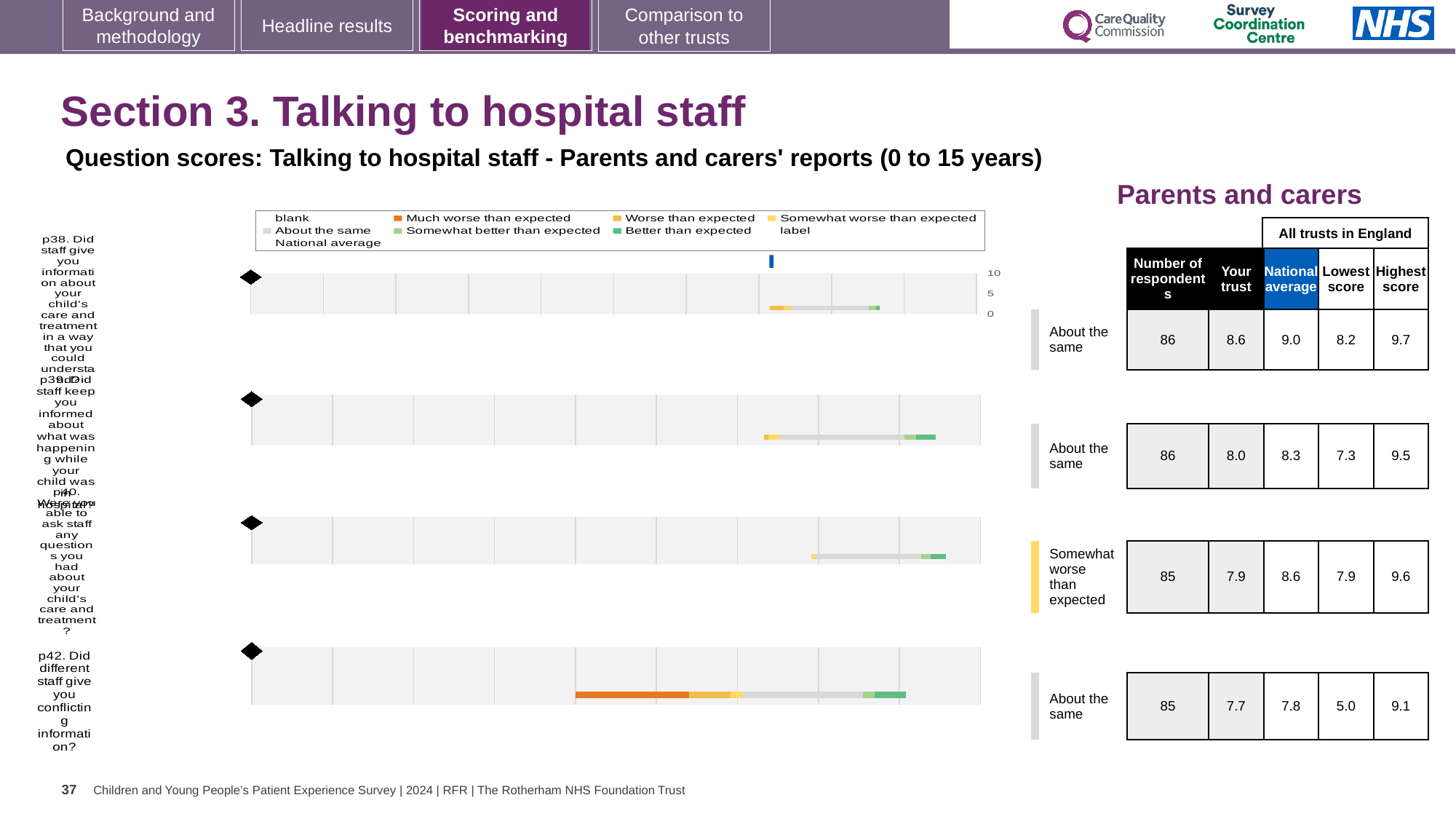
In the legend, which colour represents 'About the same'? grey What kind of chart is used for question p38 on the slide? bar chart Which question's chart is labelled 'Somewhat worse than expected' in the benchmark column? p40 In the table beside the charts, is the 'Your trust' score for p40 larger or smaller than the National average for p40? smaller How many entries does the legend above the charts list? 9 How many separate benchmark bar charts are shown on the slide? 4 In the table beside the charts, what is the National average for p42 (Did different staff give you conflicting information)? 7.8 In the table beside the charts, which question has the lowest 'Lowest score' value? p42 In the table beside the charts, which question has the highest 'Your trust' score? p38 In the table beside the charts, what is the 'Your trust' score for p38 (Did staff give you information about your child's care and treatment in a way that you could understand)? 8.6 In the table beside the charts, what is the difference between the Highest score and Lowest score for p42? 4.1 In the legend, which colour represents 'Much worse than expected'? orange